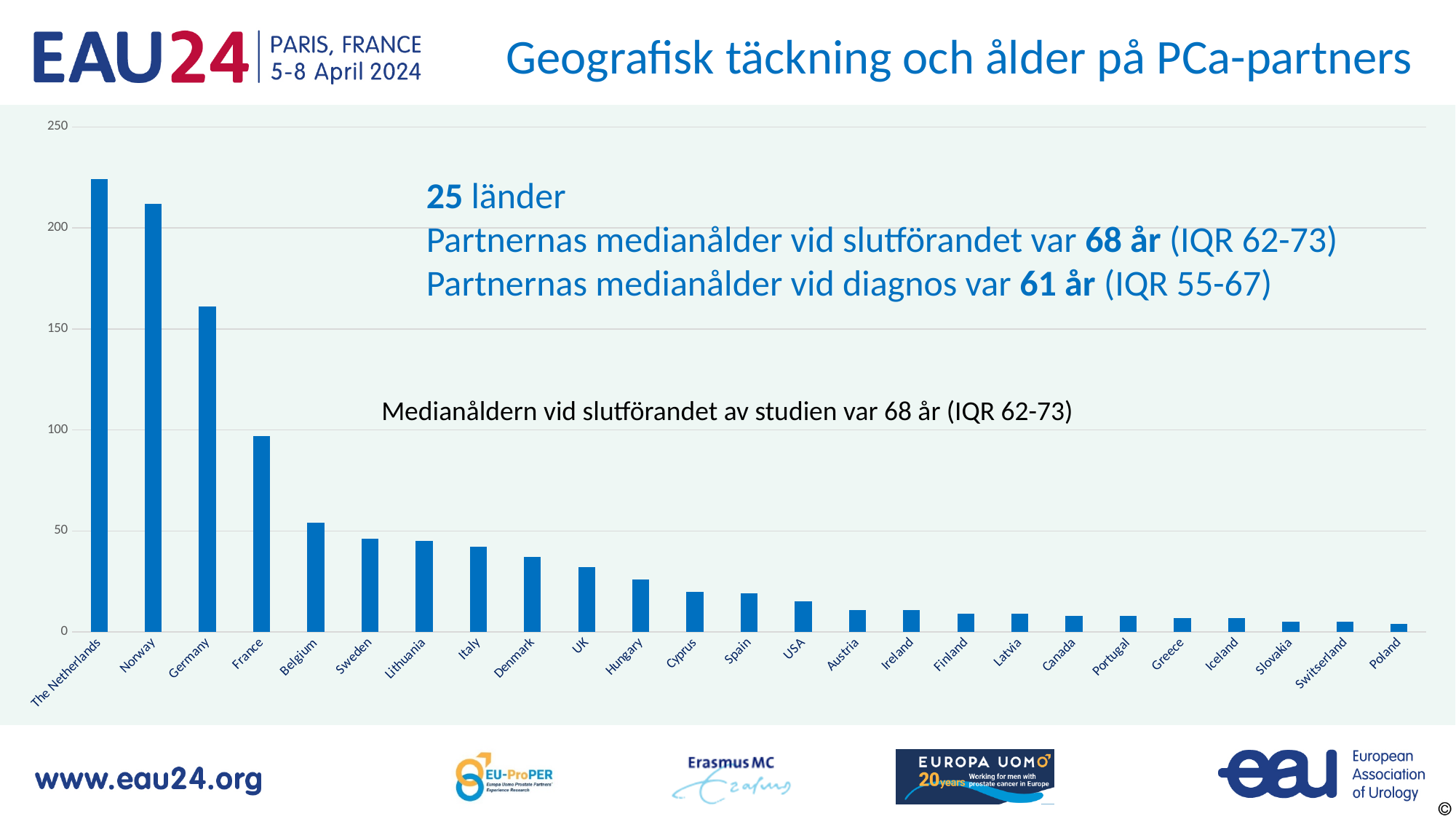
Is the value for Germany greater or less than 150? greater What is the highest value shown on the y axis of the chart? 250 Is the value for The Netherlands greater or less than 200? greater Which country has the lowest bar in the chart? Poland Is the value for Belgium greater or less than 50? greater What kind of chart is shown on the slide? bar chart Which country has the highest bar in the chart? The Netherlands Which has a larger value, Germany or France? Germany Do the bar values rise or fall from left to right along the x axis? fall How many countries are shown on the x axis of the chart? 25